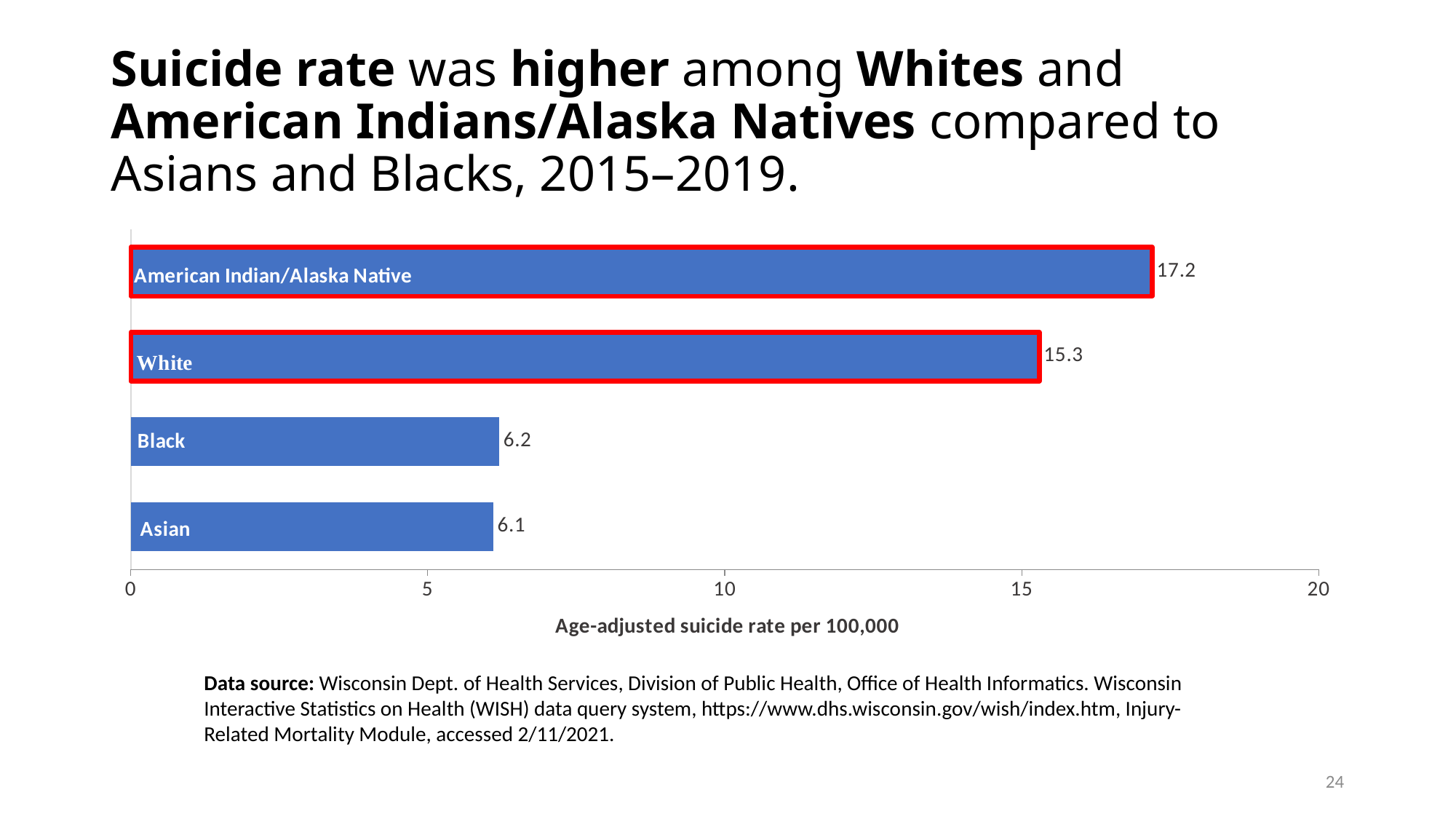
What is the age-adjusted suicide rate per 100,000 for Black? 6.2 Which group has the highest age-adjusted suicide rate? American Indian/Alaska Native What is the difference between the suicide rates for White and Black? 9.1 What is the age-adjusted suicide rate per 100,000 for American Indian/Alaska Native? 17.2 What is the difference between the suicide rates for American Indian/Alaska Native and White? 1.9 What is the age-adjusted suicide rate per 100,000 for White? 15.3 What kind of chart is shown on the slide? Bar chart Which has a higher suicide rate, American Indian/Alaska Native or White? American Indian/Alaska Native Is the suicide rate for White greater or less than 15? greater How many racial groups are shown in the chart? 4 What is the age-adjusted suicide rate per 100,000 for Asian? 6.1 What is the label of the horizontal axis of the chart? Age-adjusted suicide rate per 100,000